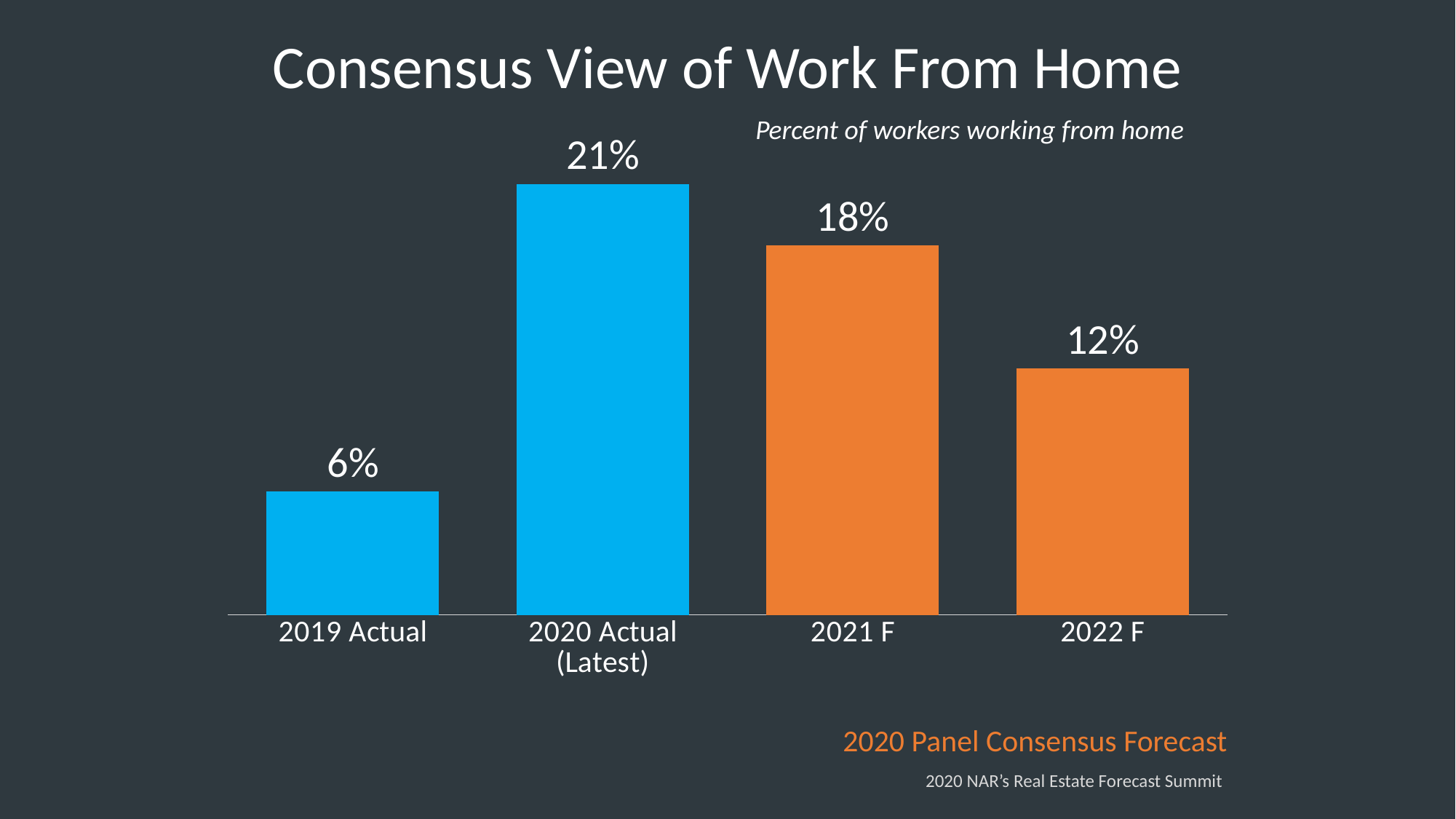
What is the value for 2020 Actual (Latest)? 21% What is the title of the chart? Consensus View of Work From Home What is the difference between the values for 2020 Actual (Latest) and 2021 F? 3% Which category has the lowest value? 2019 Actual What is the difference between the values for 2021 F and 2022 F? 6% Which is larger, the value for 2019 Actual or the value for 2022 F? 2022 F What is the value for 2022 F? 12% Which category has the highest value? 2020 Actual (Latest) What kind of chart is shown on the slide? Bar chart What is the value for 2021 F? 18% How many categories are shown on the chart? 4 What is the value for 2019 Actual? 6%